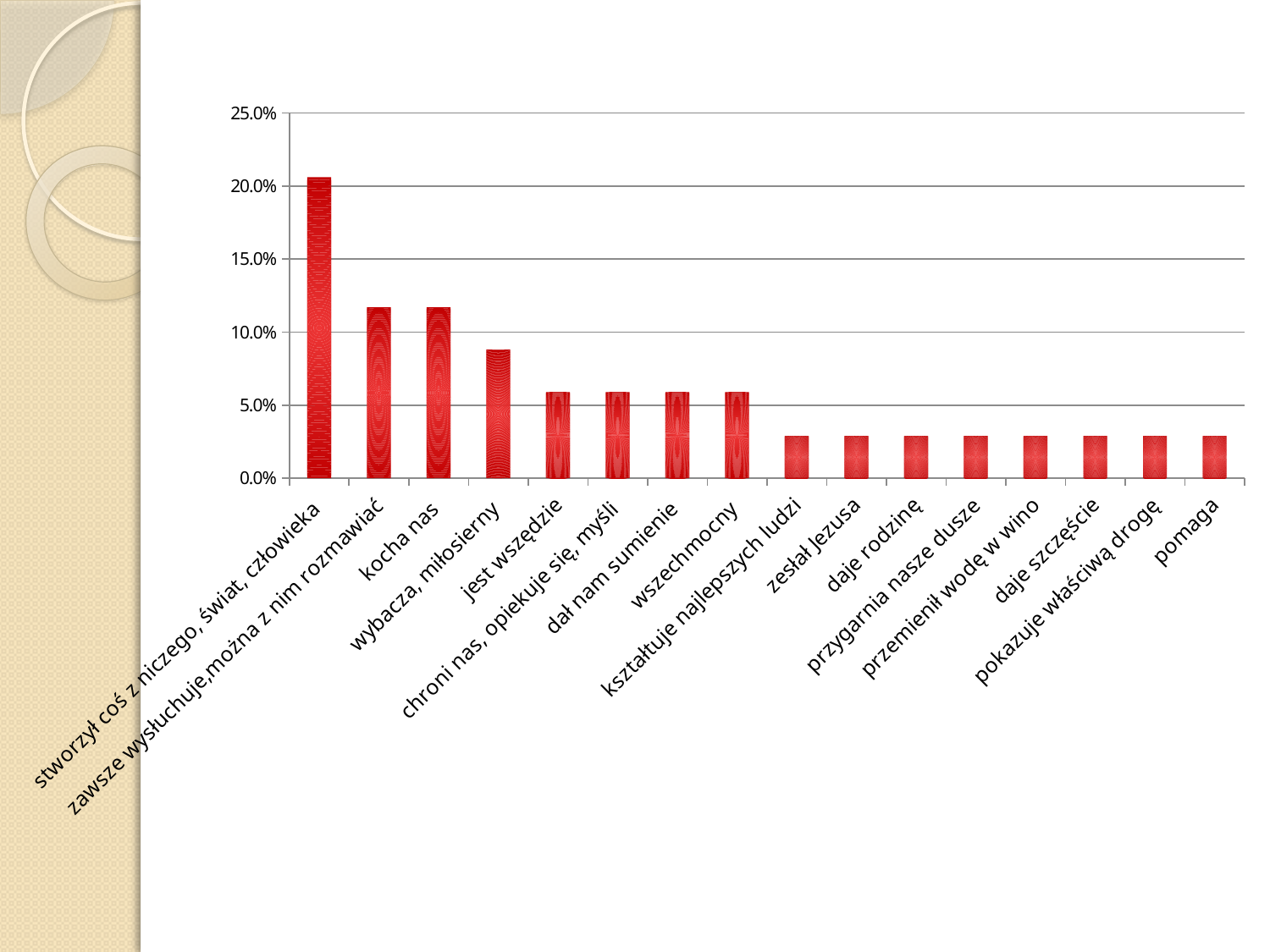
Do the values generally rise or fall from left to right along the x axis? fall What kind of chart is shown on the slide? bar chart Which is larger, the value for "kocha nas" or the value for "wybacza, miłosierny"? kocha nas Is the value for "pomaga" greater or less than 5.0%? less What colour are the bars in the chart? red How many categories are plotted on the chart? 16 Is the value for "jest wszędzie" greater or less than 5.0%? greater Which is larger, the value for "wszechmocny" or the value for "daje rodzinę"? wszechmocny Which category has the highest value? stworzył coś z niczego, świat, człowieka Is the value for "stworzył coś z niczego, świat, człowieka" greater or less than 20.0%? greater